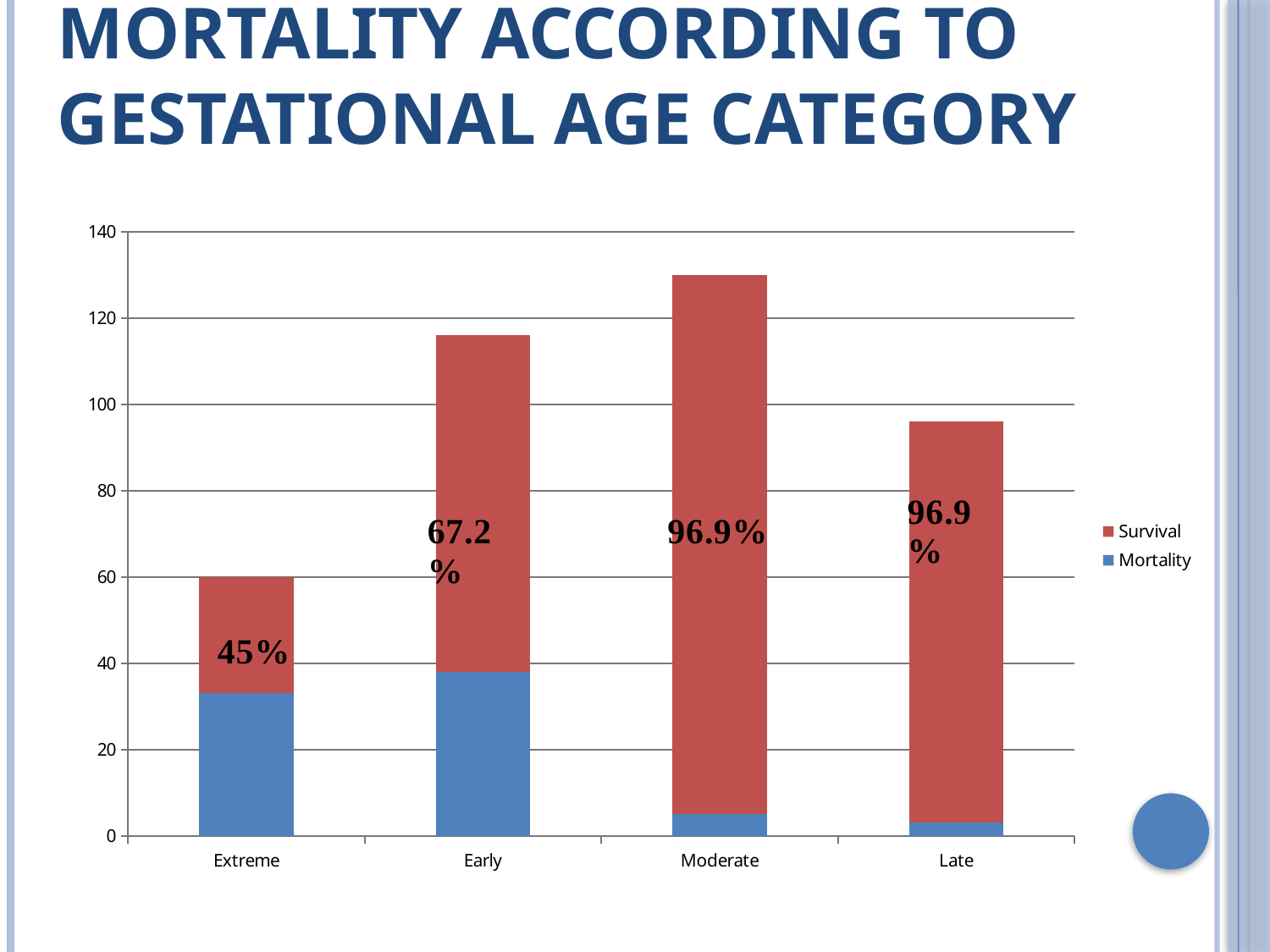
Is the total height of the Moderate bar greater or less than 120? greater What survival percentage is labelled on the Extreme bar? 45% Which colour represents the Survival series in the legend? Red What survival percentage is labelled on the Early bar? 67.2% What is the difference between the labelled survival percentages for Early and Extreme? 22.2 percentage points Is the total height of the Late bar greater or less than 100? less How many series does the legend list? 2 How many gestational age categories are shown on the x axis? 4 Which category has the lowest labelled survival percentage? Extreme What survival percentage is labelled on the Moderate bar? 96.9% What kind of chart is shown on the slide? Stacked bar chart Which category has the tallest stacked bar overall? Moderate